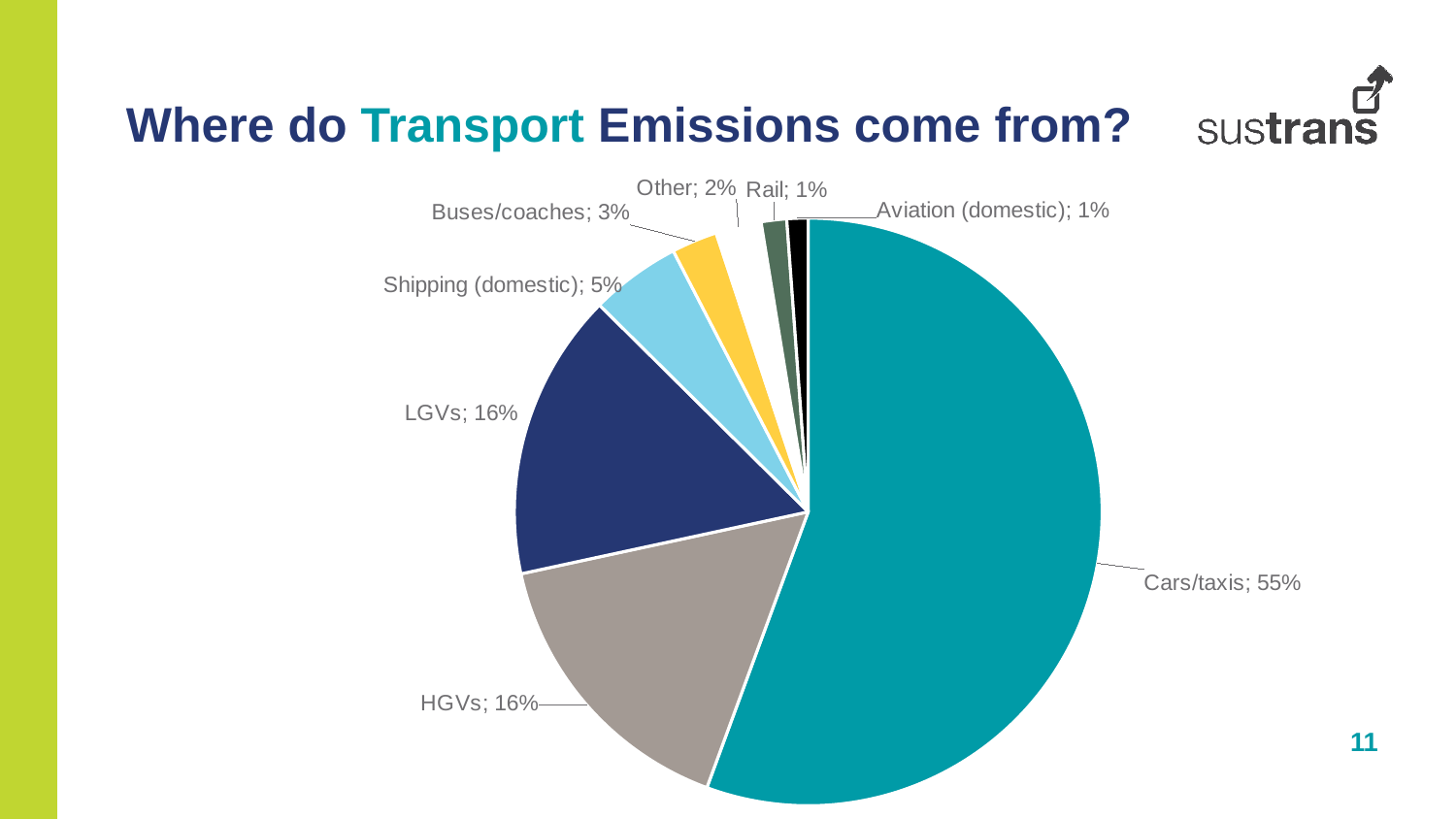
Which is larger, the share for Shipping (domestic) or the share for Buses/coaches? Shipping (domestic) Which category accounts for the largest share of transport emissions? Cars/taxis What share of transport emissions comes from HGVs? 16% What is the difference between the share for Cars/taxis and the share for LGVs? 39% What is the title of the slide containing the chart? Where do Transport Emissions come from? What share of transport emissions comes from Buses/coaches? 3% What is the difference between the share for Shipping (domestic) and the share for Other? 3% What share of transport emissions comes from Cars/taxis? 55% What share of transport emissions comes from Shipping (domestic)? 5% What kind of chart is shown on the slide? pie chart How many slices does the pie chart have? 8 What share of transport emissions comes from Rail? 1%